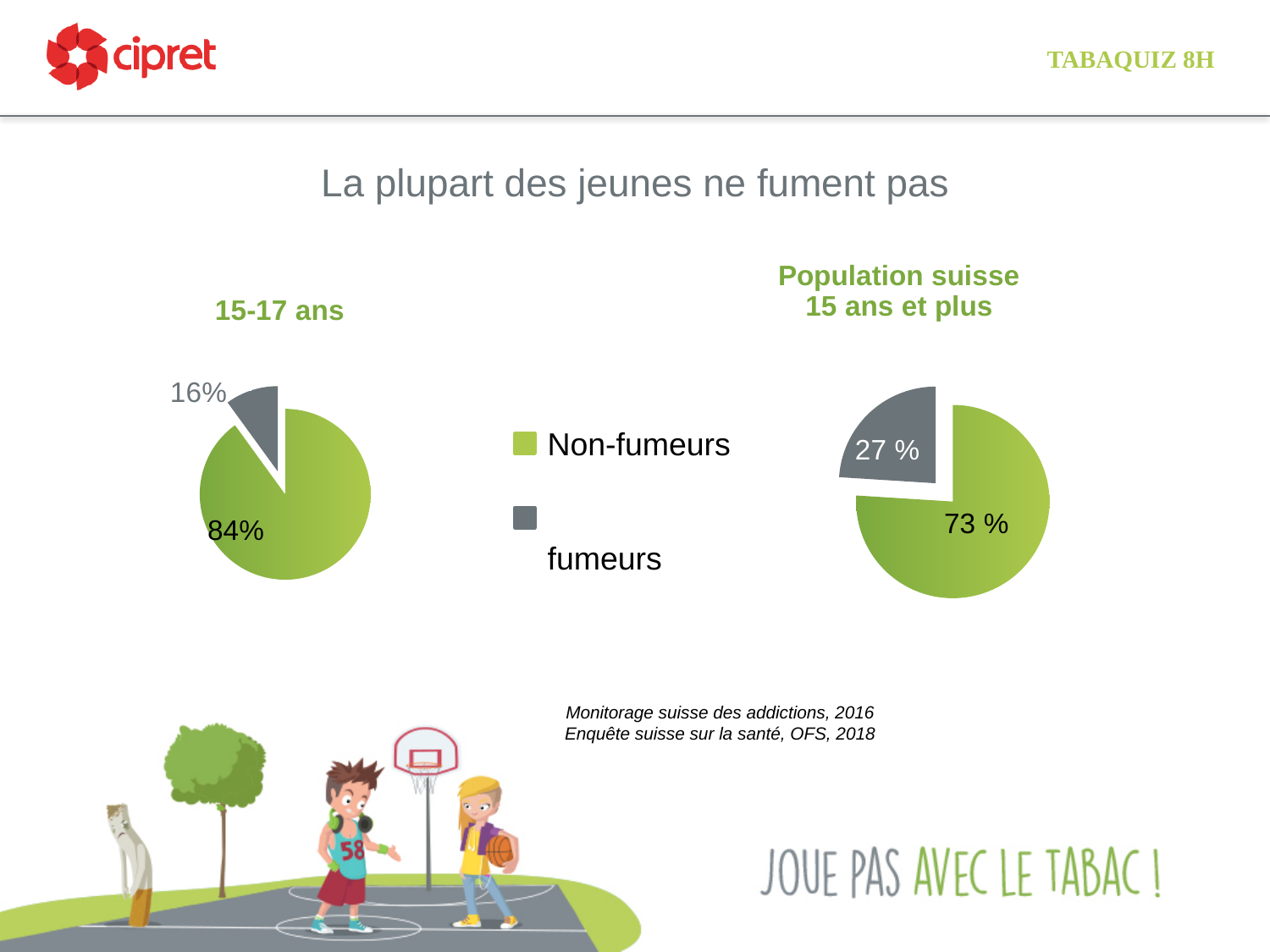
In the "Population suisse 15 ans et plus" chart, what is the difference in percentage points between Non-fumeurs and fumeurs? 46 How many slices does the "Population suisse 15 ans et plus" pie chart have? 2 In the "Population suisse 15 ans et plus" chart, what share of the pie is labelled for Non-fumeurs? 73 % In the "15-17 ans" chart, what share of the pie is labelled for Non-fumeurs? 84% In the "15-17 ans" chart, what is the difference in percentage points between Non-fumeurs and fumeurs? 68 Which colour represents Non-fumeurs in the legend? Green In the "15-17 ans" chart, which category has the largest slice? Non-fumeurs Which chart shows a larger share of fumeurs, "15-17 ans" or "Population suisse 15 ans et plus"? Population suisse 15 ans et plus What kind of chart is used for the "15-17 ans" data? Pie chart In the "Population suisse 15 ans et plus" chart, which category has the smallest slice? fumeurs In the "Population suisse 15 ans et plus" chart, what share of the pie is labelled for fumeurs? 27 % In the "15-17 ans" chart, what share of the pie is labelled for fumeurs? 16%